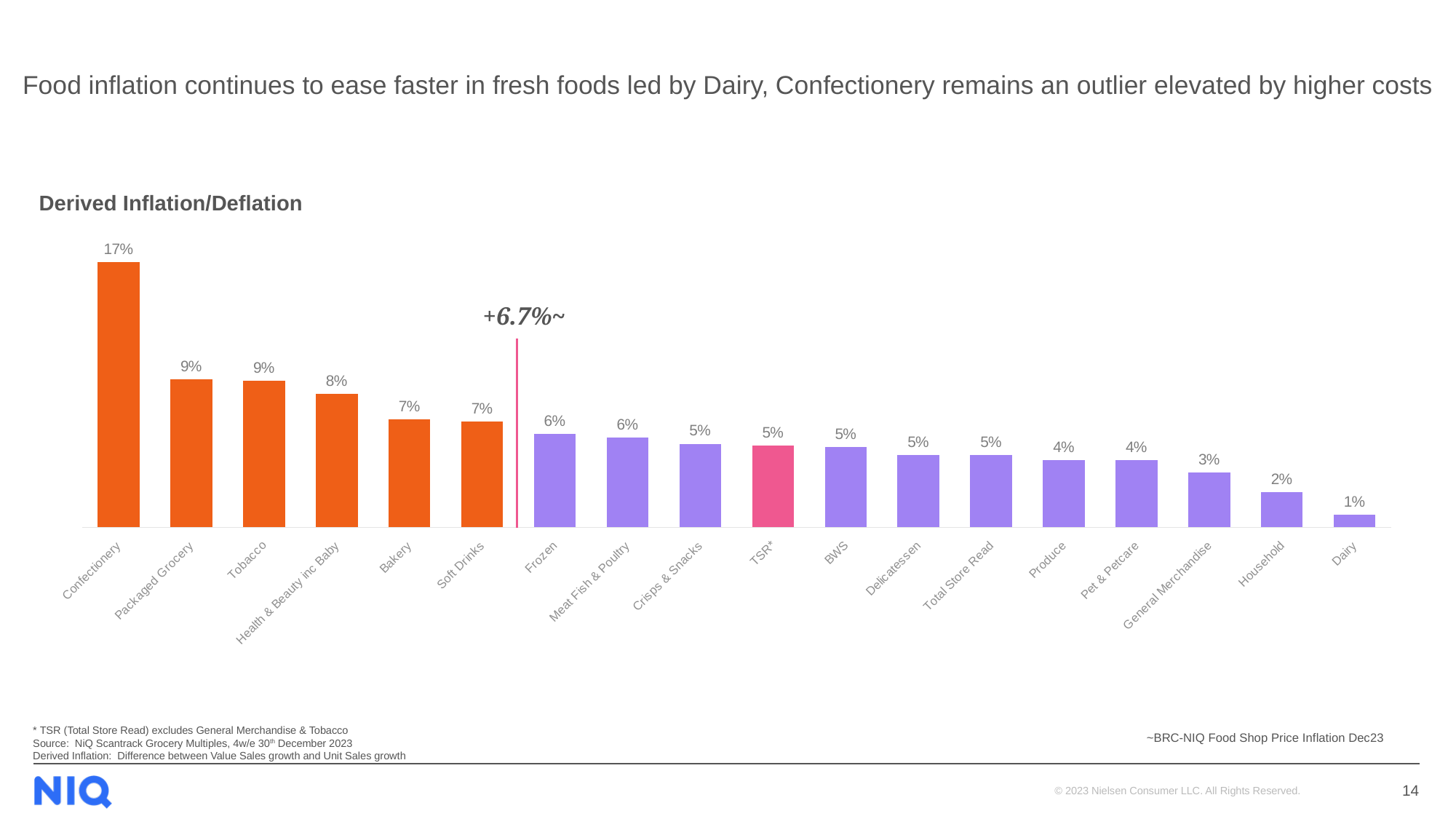
Which has a higher derived inflation, Bakery or Household? Bakery What is the derived inflation value for Confectionery? 17% What is the derived inflation value for TSR*? 5% Which category has the highest derived inflation? Confectionery What is the derived inflation value for Health & Beauty inc Baby? 8% What type of chart is shown on the slide? Bar chart How many categories are shown in the chart? 18 Do the values rise or fall moving from left to right along the x axis? Fall What is the difference between the derived inflation for Confectionery and Packaged Grocery? 8% Which category has the lowest derived inflation? Dairy What is the derived inflation value for Dairy? 1% What is the title of the chart? Derived Inflation/Deflation